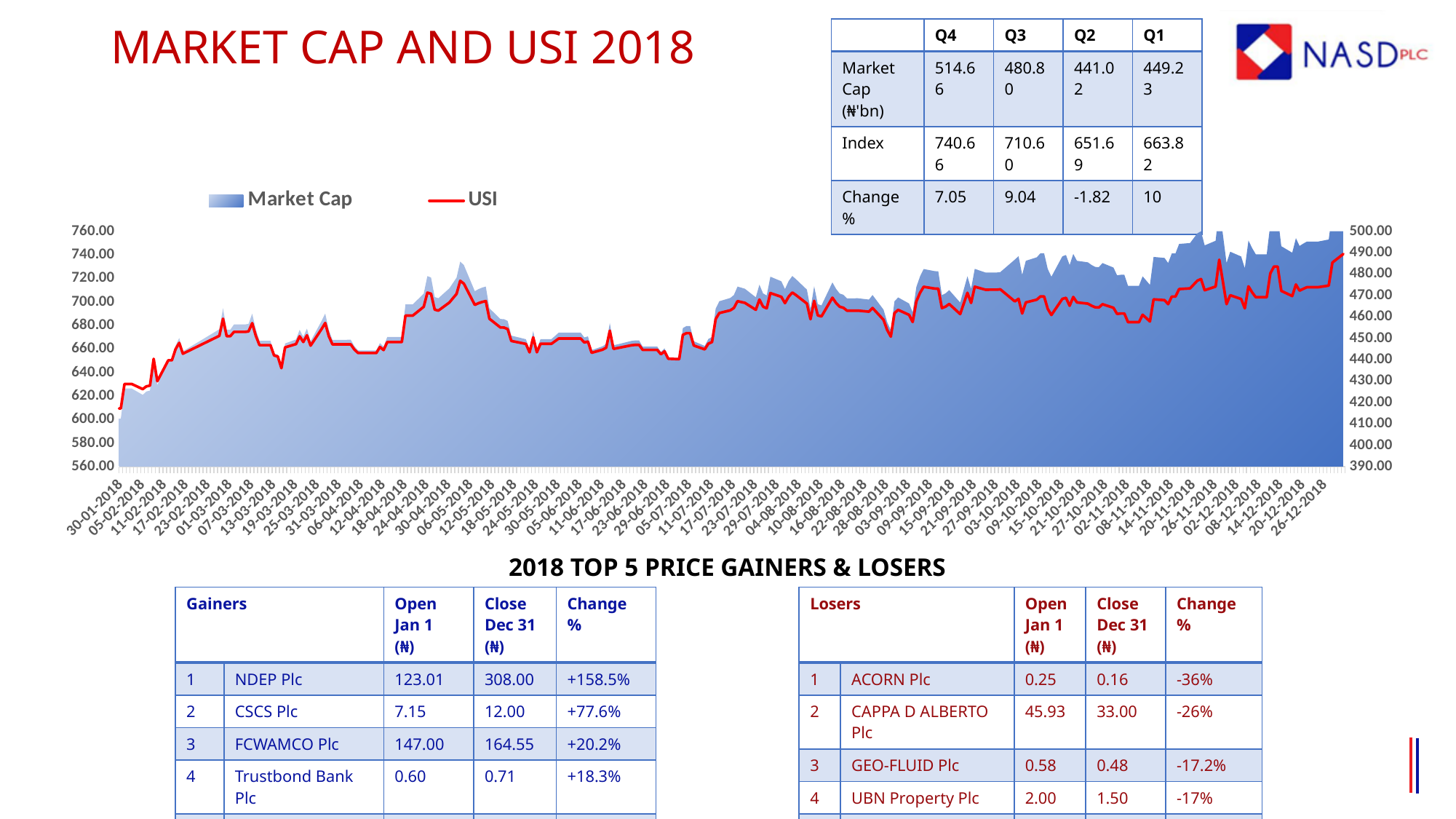
At which date label does the USI line reach its highest point? 26-12-2018 Is the USI value at 30-01-2018 greater or less than 620.00 on the left axis? less What are the two series named in the chart legend? Market Cap and USI What kind of chart is used to show Market Cap in the chart? Area chart Is the Market Cap value at 30-01-2018 greater or less than 430.00 on the right axis? less Which is higher, the USI value at 26-12-2018 or the USI value at 30-01-2018? 26-12-2018 At which date label does the USI line reach its lowest point? 30-01-2018 What is the title of the chart on the slide? MARKET CAP AND USI 2018 What is the highest value shown on the left vertical axis of the chart? 760.00 How many series does the chart legend list? 2 Overall, does the USI line rise or fall from 30-01-2018 to 26-12-2018? Rise